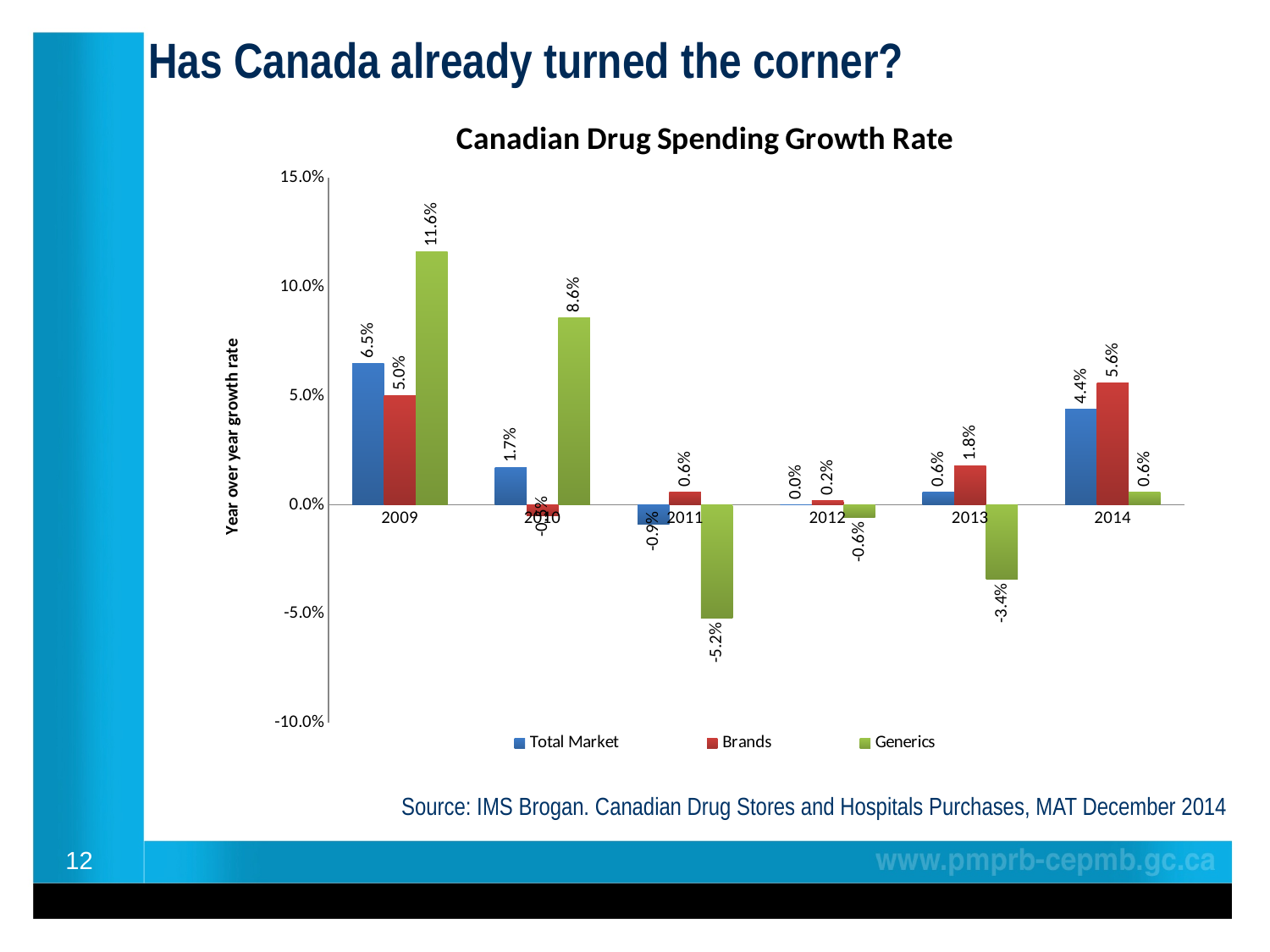
How many years are shown on the x axis? 6 In 2013, which is larger: the Brands growth rate or the Total Market growth rate? Brands What is the Total Market growth rate in 2014? 4.4% What kind of chart is shown on the slide? Bar chart In which year is the Generics growth rate highest? 2009 What is the difference between the Brands and Total Market growth rates in 2014? 1.2 percentage points What is the Generics growth rate in 2011? -5.2% In which year is the Generics growth rate lowest? 2011 What is the Brands growth rate in 2013? 1.8% What is the Generics growth rate in 2009? 11.6% How many series does the legend list? 3 Does the Generics growth rate rise or fall from 2009 to 2011? Fall